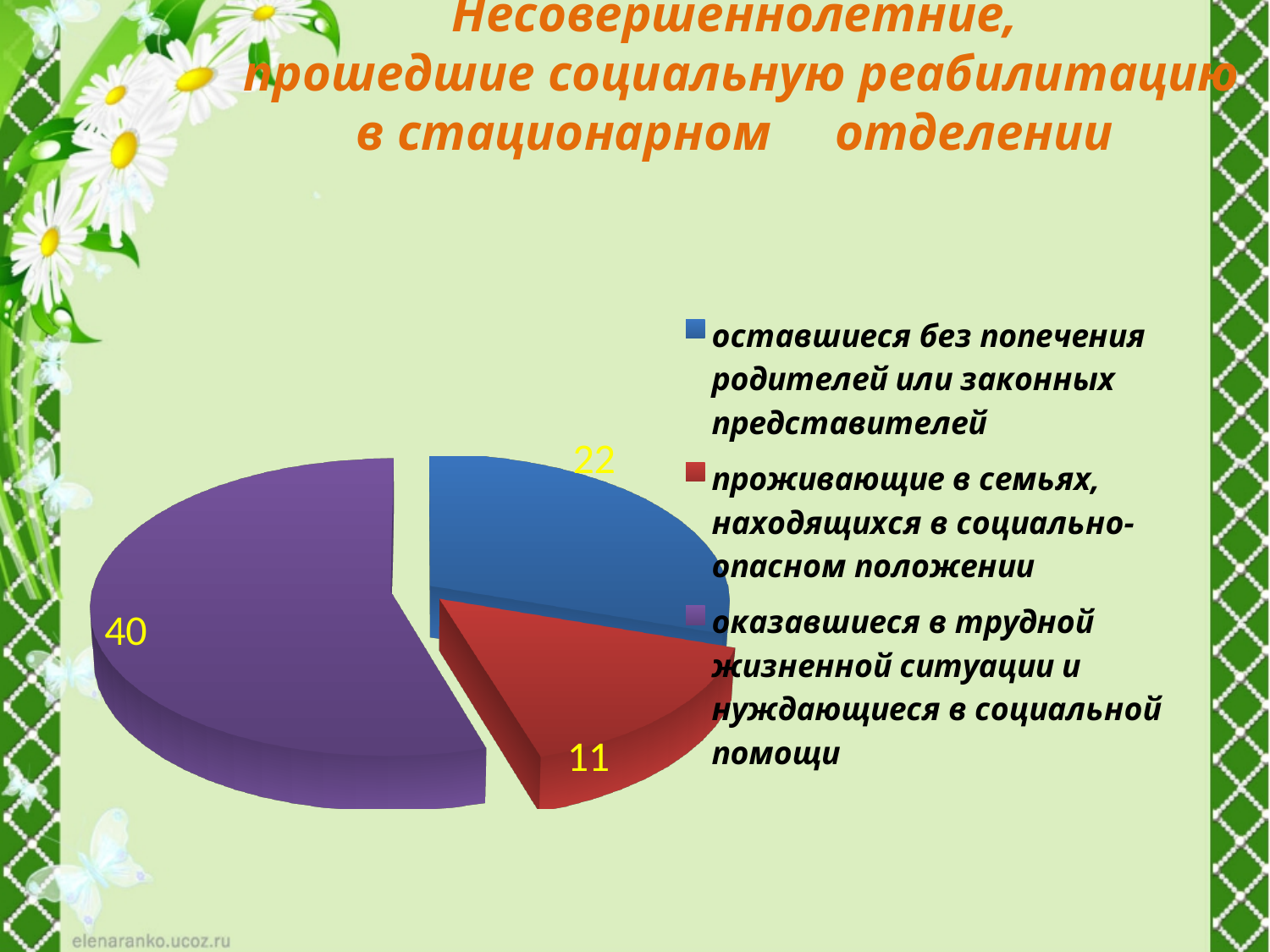
What is the total of all three slices in the pie chart? 73 Which category has the smallest slice of the pie? проживающие в семьях, находящихся в социально-опасном положении Which category has the largest slice of the pie? оказавшиеся в трудной жизненной ситуации и нуждающиеся в социальной помощи What kind of chart is shown on the slide? Pie chart What is the value for 'проживающие в семьях, находящихся в социально-опасном положении'? 11 What colour is the slice for 'проживающие в семьях, находящихся в социально-опасном положении'? Red What is the value for 'оказавшиеся в трудной жизненной ситуации и нуждающиеся в социальной помощи'? 40 How many entries does the legend list? 3 What is the difference between the value for 'оказавшиеся в трудной жизненной ситуации и нуждающиеся в социальной помощи' and the value for 'оставшиеся без попечения родителей или законных представителей'? 18 What is the value for 'оставшиеся без попечения родителей или законных представителей'? 22 Which is larger: the value for 'оставшиеся без попечения родителей или законных представителей' or the value for 'проживающие в семьях, находящихся в социально-опасном положении'? оставшиеся без попечения родителей или законных представителей How many slices does the pie chart have? 3